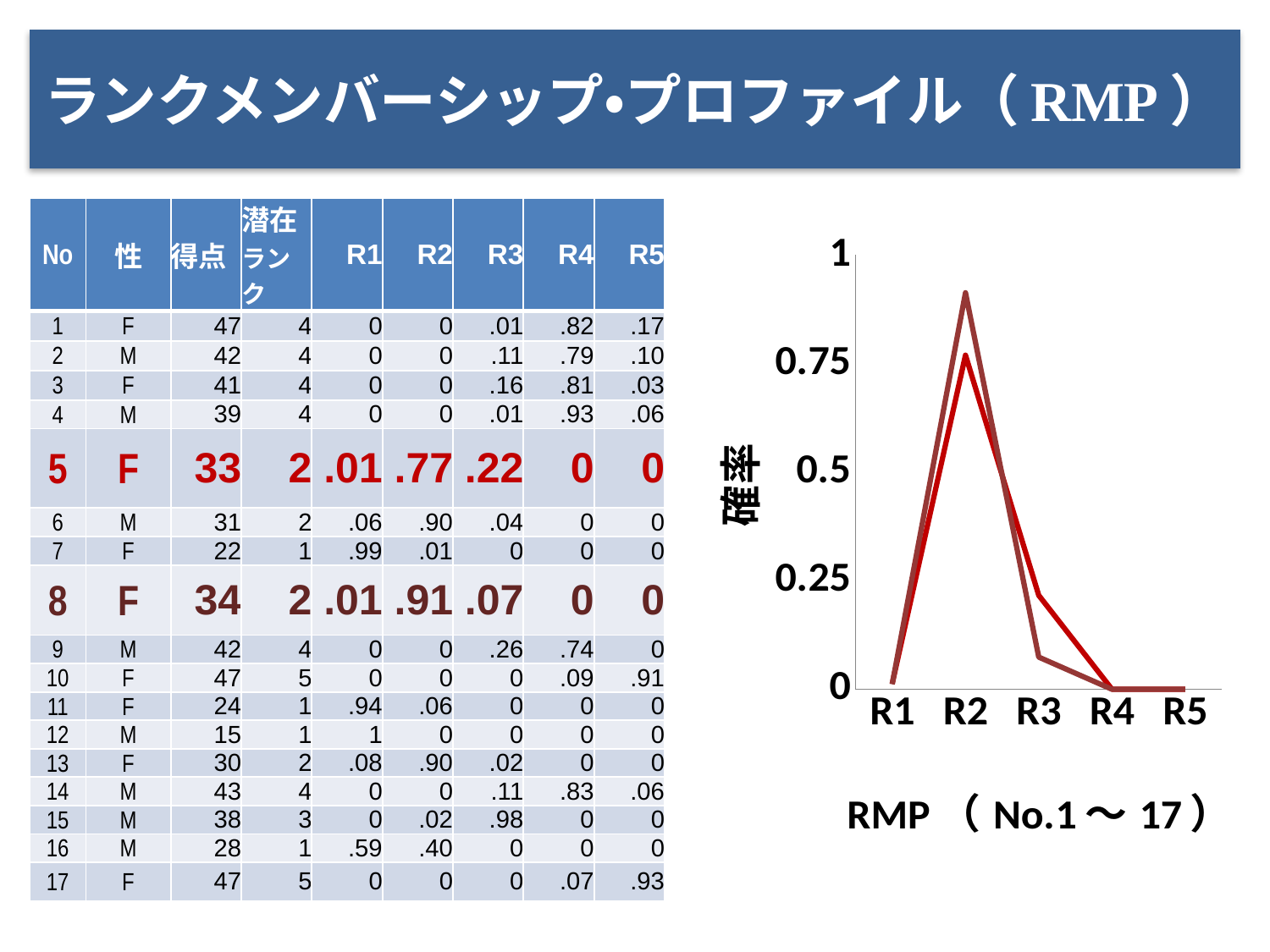
Is the value of the red line at R2 greater or less than 0.5? greater What value do both lines show at R4? 0 What kind of chart is shown on the right side of the slide? line chart How many categories are shown on the x axis of the chart? 5 Do the values of the lines rise or fall from R2 to R5? fall At R2, which line is higher, the red line or the dark brown line? the dark brown line What is the label on the y axis of the chart? 確率 At R3, which line is higher, the red line or the dark brown line? the red line Is the value of the dark brown line at R3 greater or less than 0.25? less Is the value of the dark brown line at R2 greater or less than 0.75? greater How many lines are plotted on the chart? 2 At which x-axis category do both lines reach their highest value? R2